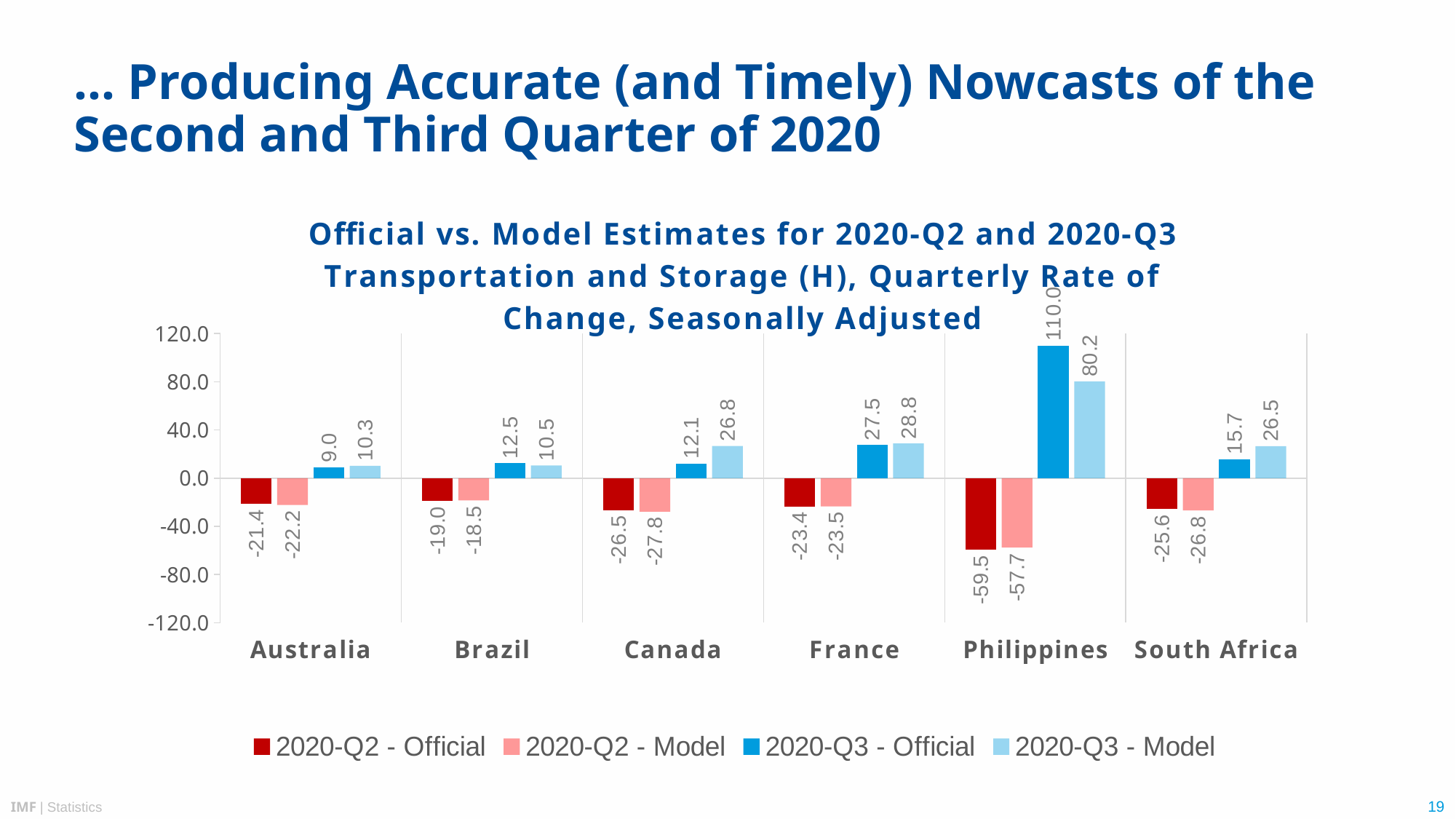
Which country has the highest 2020-Q3 - Official value? Philippines What is the difference between the 2020-Q3 - Official and 2020-Q3 - Model values for the Philippines? 29.8 What kind of chart is shown on the slide? Bar chart Which is larger for Brazil: the 2020-Q3 - Official value or the 2020-Q3 - Model value? 2020-Q3 - Official What is the 2020-Q3 - Official value for the Philippines? 110.0 What is the 2020-Q2 - Official value for France? -23.4 Which country has the lowest 2020-Q2 - Official value? Philippines What is the 2020-Q2 - Model value for Canada? -27.8 What is the difference between the 2020-Q2 - Official and 2020-Q2 - Model values for Australia? 0.8 How many countries are shown on the x axis? 6 What is the 2020-Q3 - Model value for South Africa? 26.5 How many series does the legend list? 4